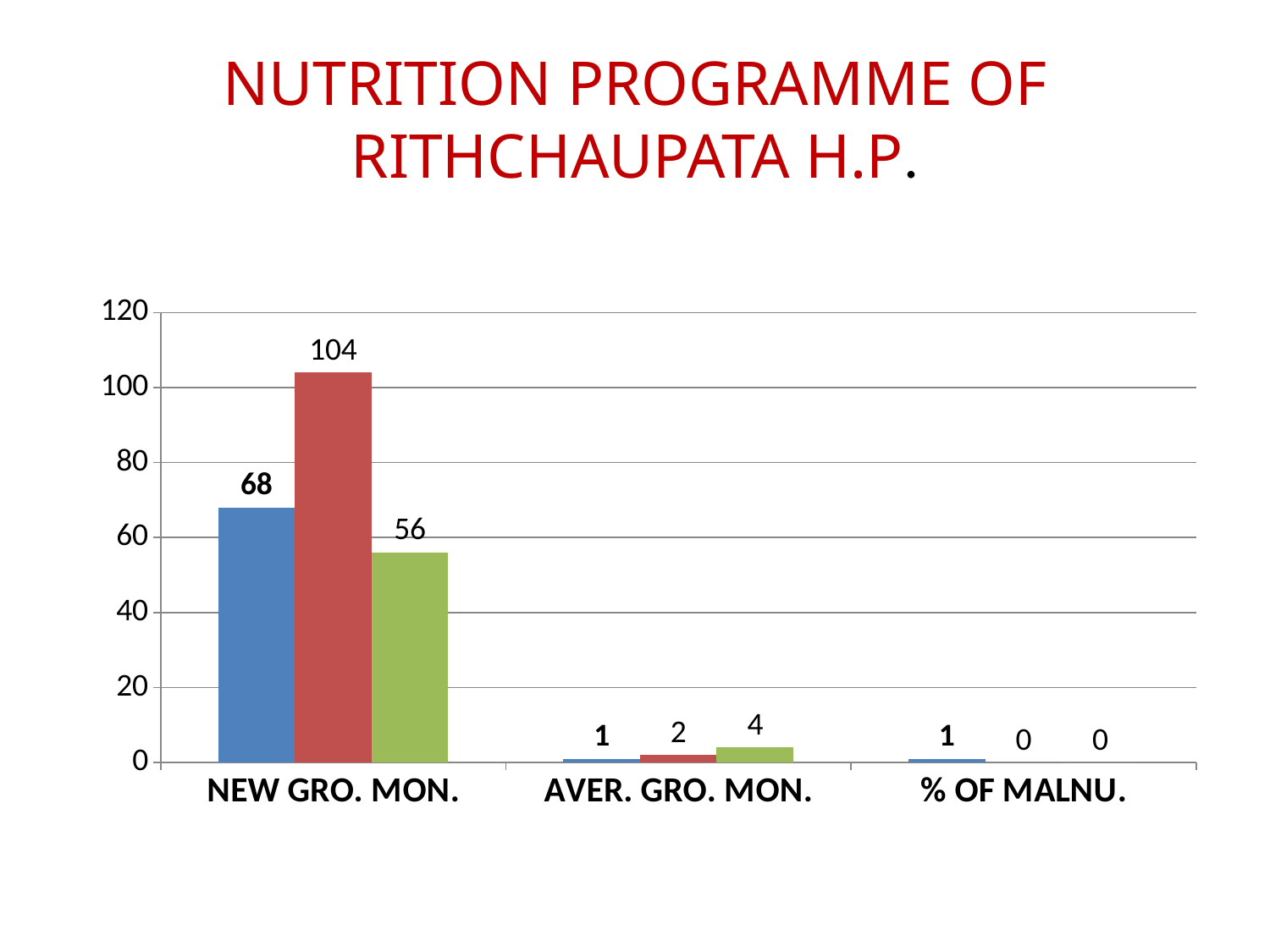
What is the value of the blue bar for NEW GRO. MON.? 68 What is the total of the three bars in the AVER. GRO. MON. category? 7 What is the value of the red bar for NEW GRO. MON.? 104 What type of chart is shown on the slide? Bar chart What is the difference between the red bar and the green bar for NEW GRO. MON.? 48 What is the title of the slide containing the chart? NUTRITION PROGRAMME OF RITHCHAUPATA H.P. Which bar in the NEW GRO. MON. category has the lowest value? The green bar (56) Which is larger for NEW GRO. MON., the blue bar or the green bar? The blue bar What is the value of the green bar for AVER. GRO. MON.? 4 What is the value of the blue bar for % OF MALNU.? 1 Which bar in the NEW GRO. MON. category has the highest value? The red bar (104) How many categories are shown on the x axis? 3